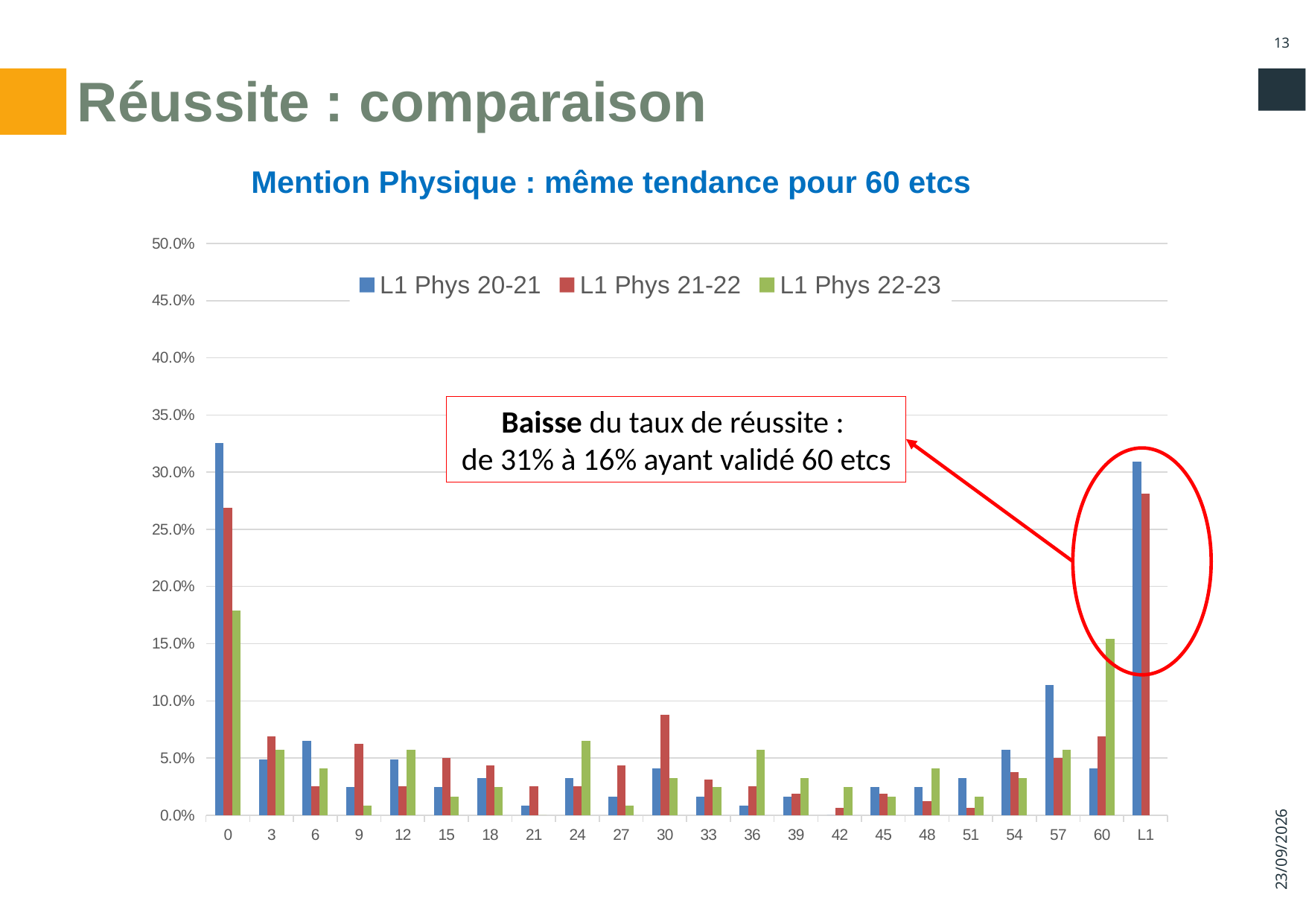
Is the value for L1 Phys 21-22 at category L1 greater or less than 30.0%? less At category 24, which series has the larger value, L1 Phys 21-22 or L1 Phys 22-23? L1 Phys 22-23 Which series has no bar at the L1 category? L1 Phys 22-23 Is the value for L1 Phys 22-23 at category 60 greater or less than 10.0%? greater How many categories are shown on the x axis? 22 Is the value for L1 Phys 22-23 at category 0 greater or less than 20.0%? less What kind of chart is shown on the slide? bar chart At category 30, which series has the larger value, L1 Phys 20-21 or L1 Phys 21-22? L1 Phys 21-22 For the L1 Phys 22-23 series, which category has the highest value? 0 How many series does the legend list? 3